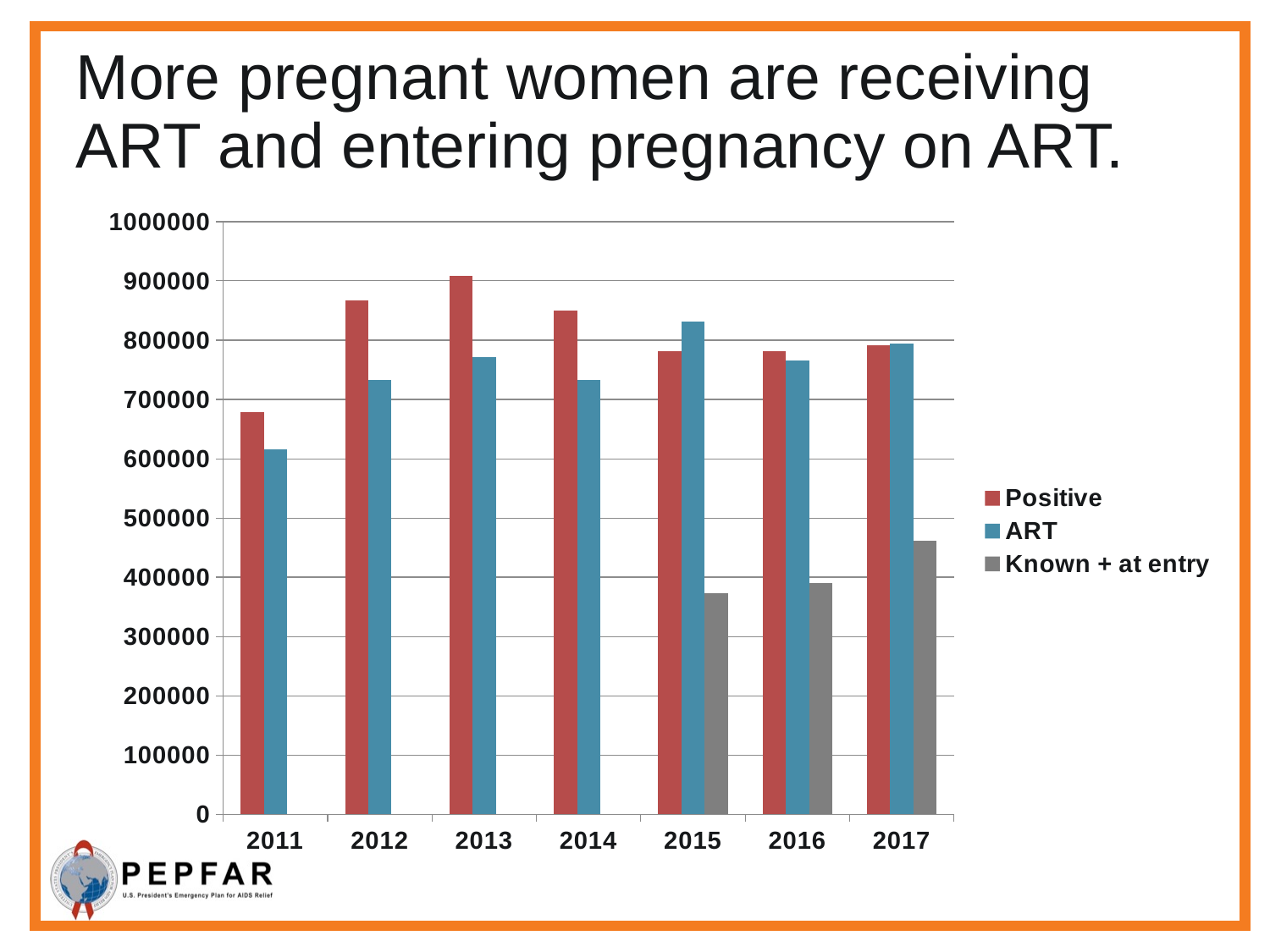
How many years are shown on the x axis? 7 Is the value for ART in 2015 greater or less than 800000? greater In which year is the ART series highest? 2015 What kind of chart is shown on the slide? Bar chart In which year is the Known + at entry series lowest? 2015 In which year is the Positive series highest? 2013 In which year is the Positive series lowest? 2011 How many series does the legend list? 3 Does the Known + at entry series rise or fall from 2015 to 2017? Rise Is the value for Positive in 2011 greater or less than 700000? less In 2015, which is larger, Positive or ART? ART Is the value for Known + at entry in 2017 greater or less than 400000? greater